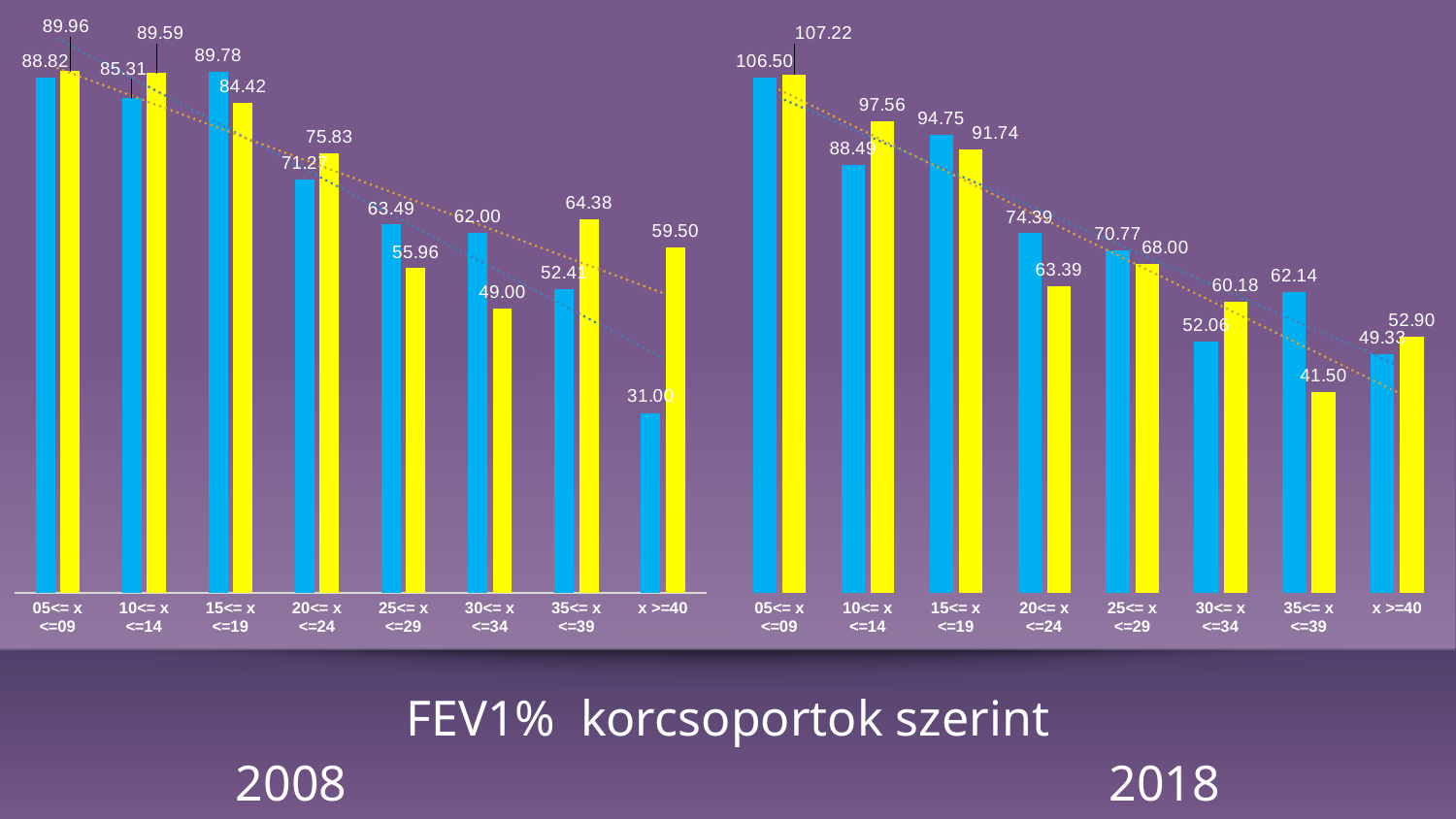
In the 2018 chart, what is the difference between the yellow bar and the blue bar for the 10<= x <=14 age group? 9.07 In the 2018 chart, what is the value of the blue bar for the 20<= x <=24 age group? 74.39 In the 2008 chart, which age group has the lowest blue bar? x >=40 What type of chart is used for the 2018 data? bar chart In the 2008 chart, what is the value of the blue bar for the x >=40 age group? 31.00 How many age groups are shown on the x axis of the 2008 chart? 8 In the 2008 chart, what is the difference between the yellow bar and the blue bar for the x >=40 age group? 28.50 In the 2008 chart, what is the value of the yellow bar for the 30<= x <=34 age group? 49.00 In the 2018 chart, for the 35<= x <=39 age group, which bar is larger, blue or yellow? blue In the 2018 chart, what is the value of the yellow bar for the 05<= x <=09 age group? 107.22 In the 2018 chart, which age group has the lowest yellow bar? 35<= x <=39 In the 2018 chart, which age group has the highest blue bar? 05<= x <=09